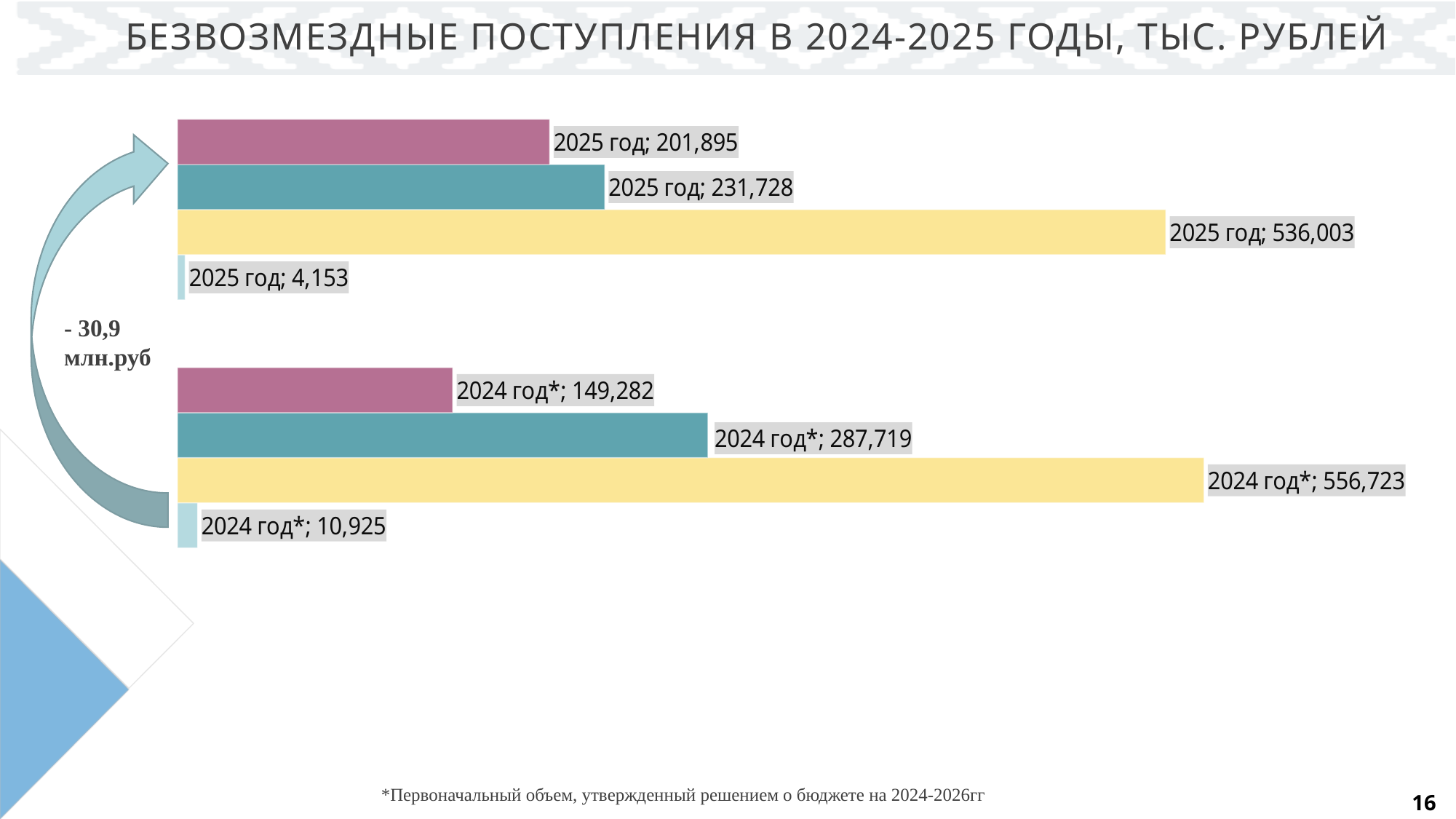
Which bar has the highest value on the chart? The yellow bar for 2024 год* (556,723) What is the difference between the yellow bar for 2024 год* and the yellow bar for 2025 год? 20,720 What is the title of the slide? БЕЗВОЗМЕЗДНЫЕ ПОСТУПЛЕНИЯ В 2024-2025 ГОДЫ, ТЫС. РУБЛЕЙ What is the value of the yellow bar for 2025 год? 536,003 Which is larger: the teal bar for 2025 год or the teal bar for 2024 год*? 2024 год* What is the value of the teal bar for 2024 год*? 287,719 Which is larger: the purple bar for 2025 год or the purple bar for 2024 год*? 2025 год How many bars are plotted on the chart in total? 8 Which bar has the lowest value on the chart? The light blue bar for 2025 год (4,153) What is the value of the light blue bar for 2025 год? 4,153 What kind of chart is shown on the slide? Bar chart What is the value of the purple bar for 2024 год*? 149,282